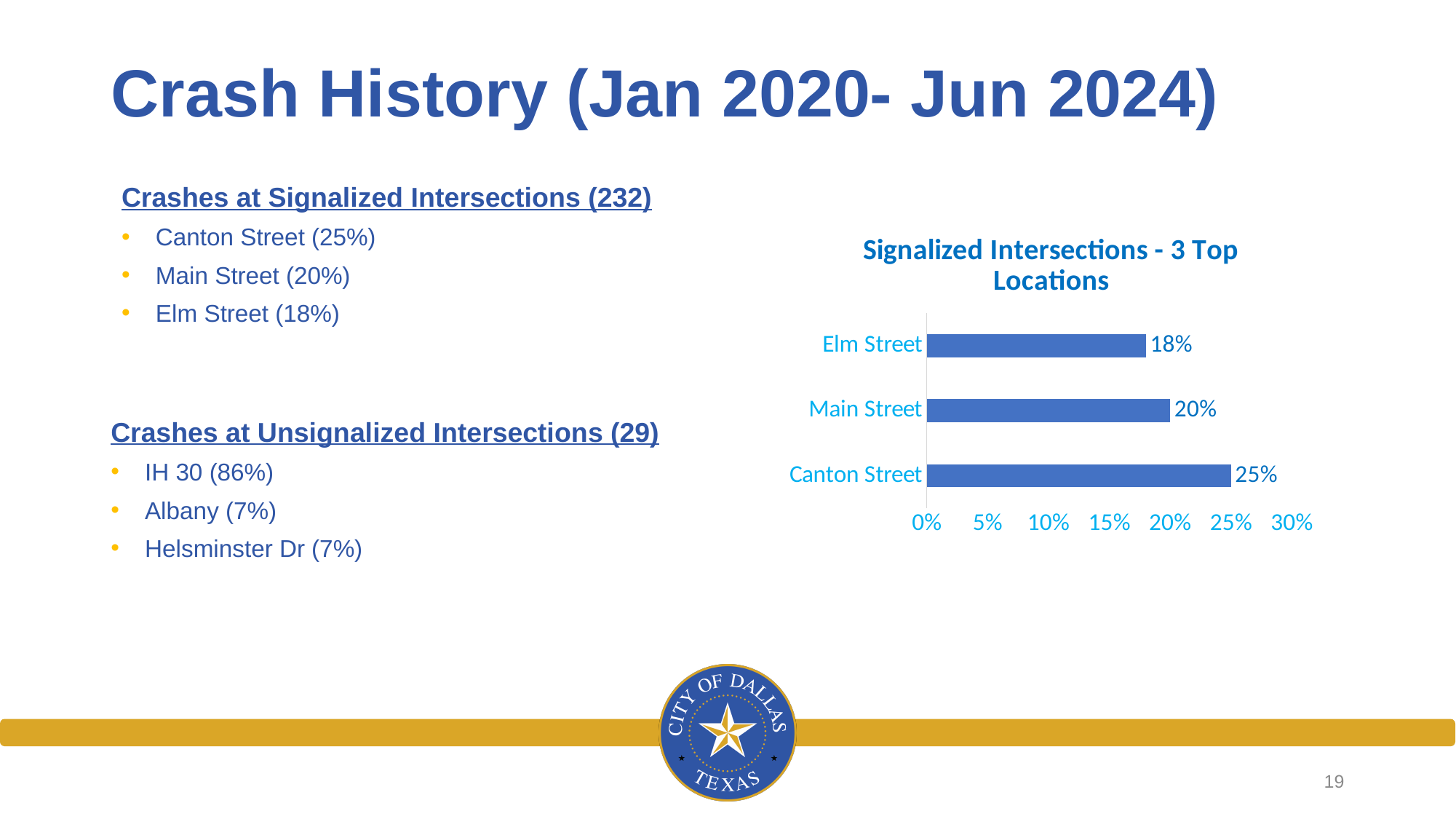
How many locations are shown in the chart? 3 What is the value for Canton Street in the chart? 25% Which location has the lowest value in the chart? Elm Street What is the difference between the values for Canton Street and Elm Street? 7% Is the value for Canton Street greater or less than 20%? greater Which has a larger value, Main Street or Elm Street? Main Street What is the value for Elm Street in the chart? 18% Which location has the highest value in the chart? Canton Street What is the value for Main Street in the chart? 20% What kind of chart is shown on the slide? Bar chart What is the title of the chart? Signalized Intersections - 3 Top Locations What is the difference between the values for Main Street and Elm Street? 2%